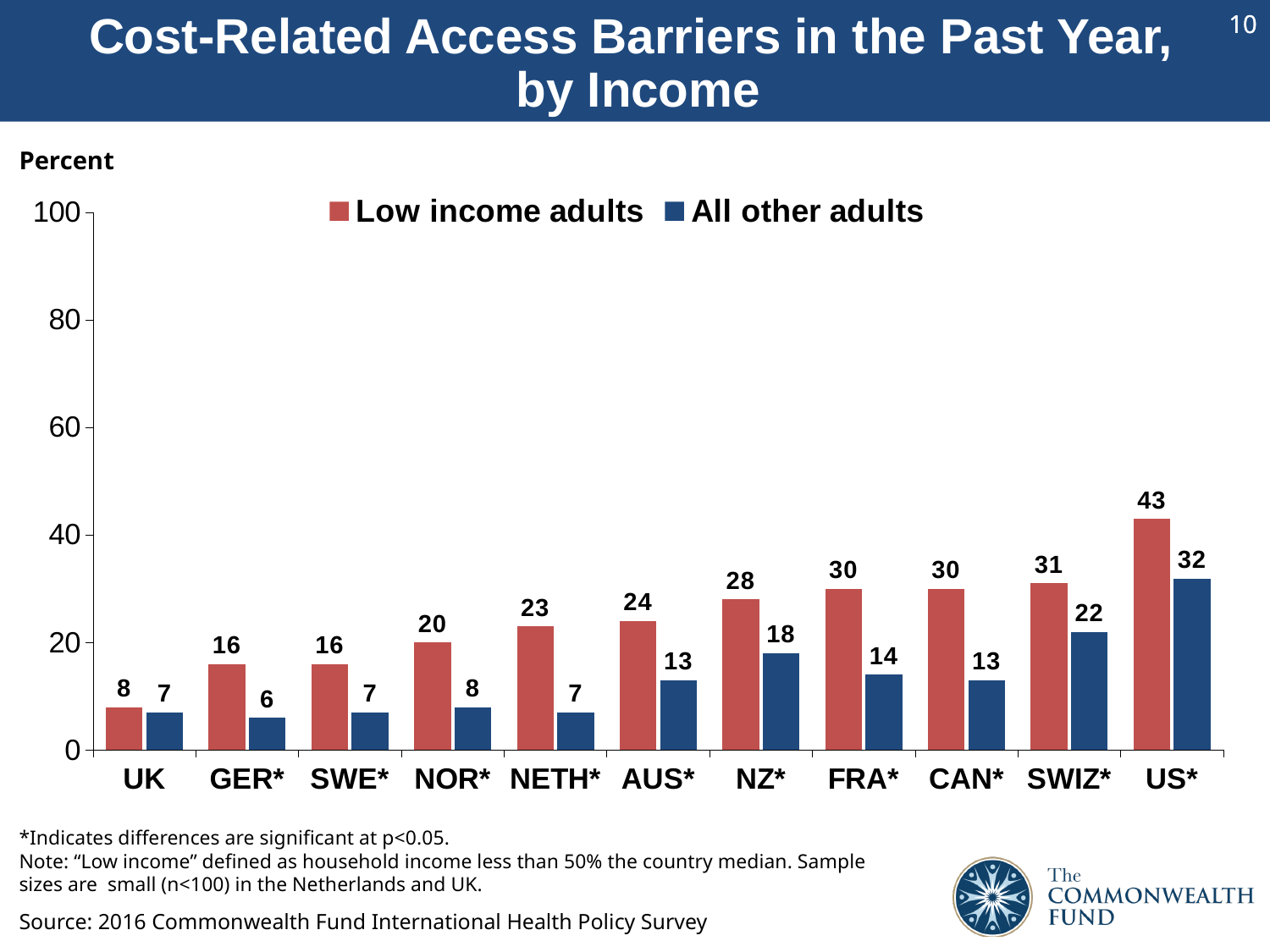
How many countries are shown on the x axis? 11 Do the Low income adults values generally rise or fall from UK to US* along the x axis? rise What colour are the bars for All other adults? blue What is the difference between Low income adults and All other adults in CAN*? 17 Is the value for Low income adults in the US* greater or less than 40? greater Which country has the highest value for Low income adults? US* Which country has the lowest value for All other adults? GER* How many series does the legend list? 2 What kind of chart is shown on the slide? bar chart What is the value for Low income adults in the US*? 43 Which is larger: the Low income adults value for SWIZ* or the Low income adults value for NETH*? SWIZ* What is the value for All other adults in NZ*? 18